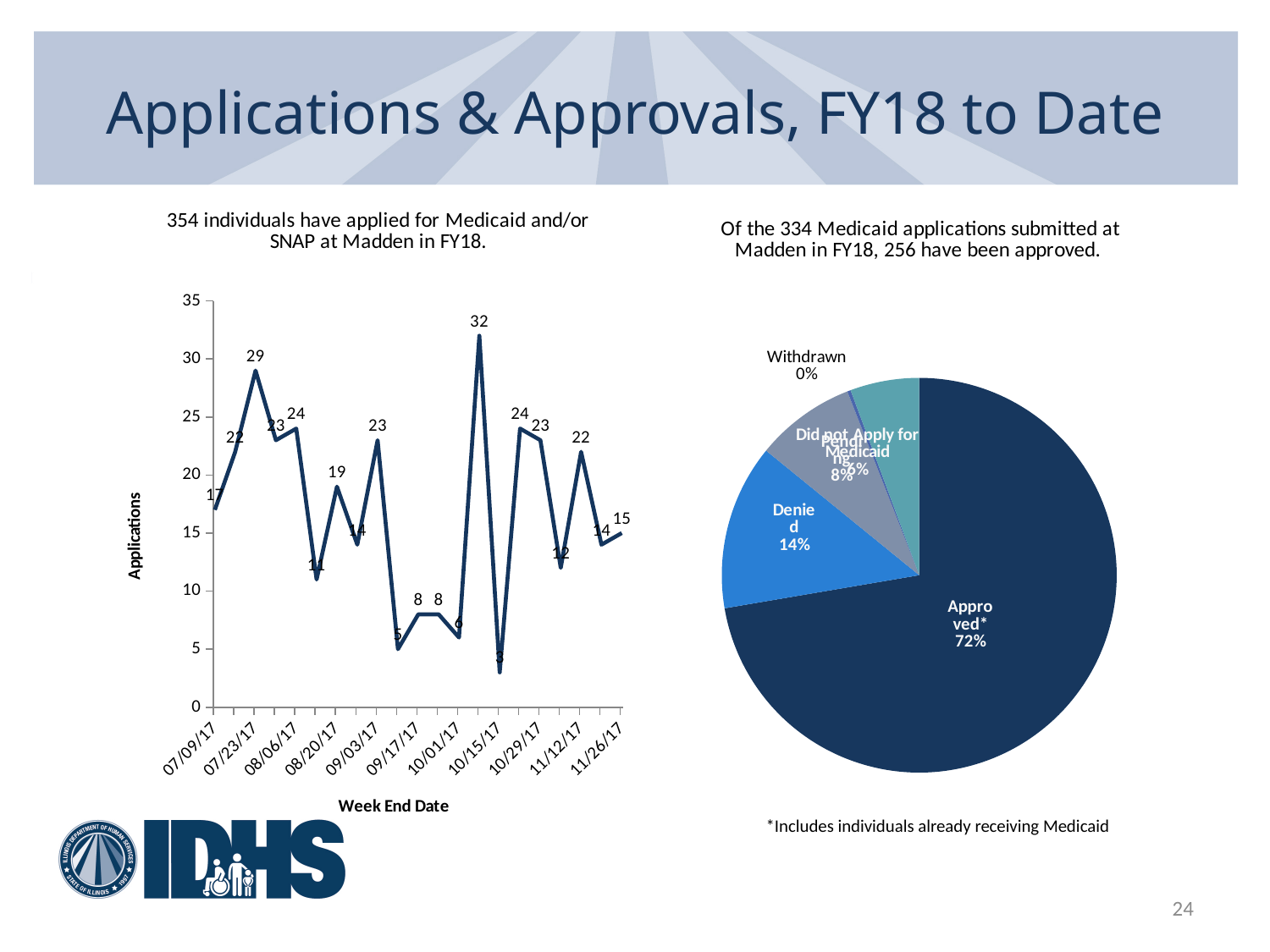
On the right pie chart, which is larger, the Denied share or the Pending share? Denied On the left line chart, what is the lowest weekly number of applications? 3 On the right pie chart, what share of Medicaid applications were Denied? 14% On the left line chart, what is the highest weekly number of applications? 32 On the right pie chart, which category has the largest slice? Approved* What kind of chart is the right chart showing Medicaid application outcomes? pie chart On the right pie chart, what share of Medicaid applications were Approved*? 72% On the left line chart, how many applications were there for the week ending 07/09/17? 17 On the left line chart, how many applications were there for the week ending 11/26/17? 15 On the right pie chart, what is the difference in percentage points between the Approved* and Denied shares? 58 percentage points What kind of chart is the left chart showing applications by week end date? line chart On the left line chart, how many weekly data points are plotted? 21